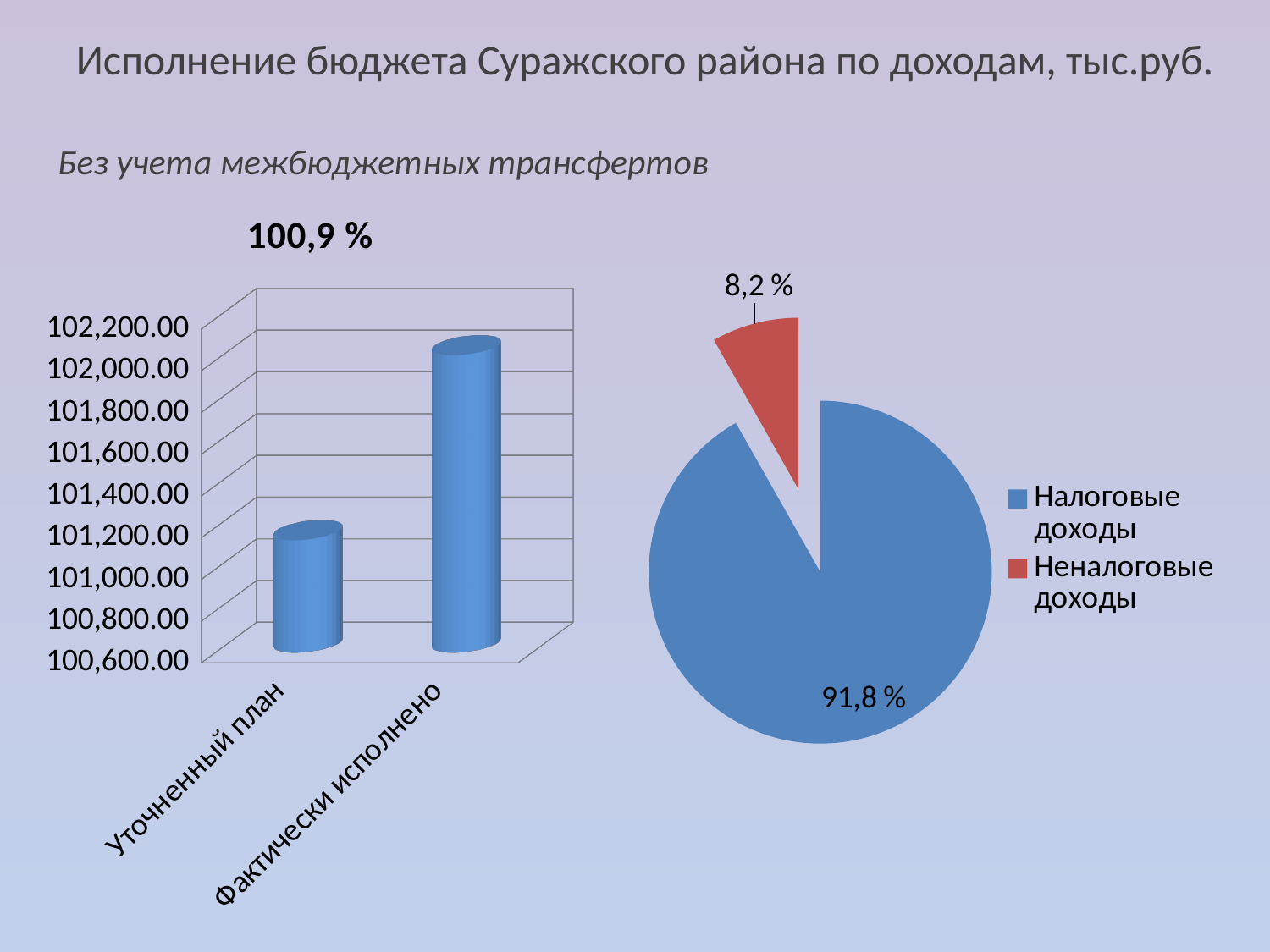
On the right chart, what share of the pie is Налоговые доходы? 91,8 % On the left chart, how many categories are shown on the x axis? 2 On the left chart, is the value for Фактически исполнено greater or less than 101,800.00? greater On the right chart, what share of the pie is Неналоговые доходы? 8,2 % On the right chart, how many entries does the legend list? 2 On the right chart, what is the difference between the Налоговые доходы and Неналоговые доходы shares? 83,6 % On the left chart, is the value for Уточненный план greater or less than 100,800.00? greater On the left chart, which category has the higher value, Уточненный план or Фактически исполнено? Фактически исполнено On the left chart, what kind of chart is it? bar chart On the right chart, what kind of chart is it? pie chart On the right chart, which slice is the largest? Налоговые доходы On the left chart, is the value for Уточненный план greater or less than 101,400.00? less